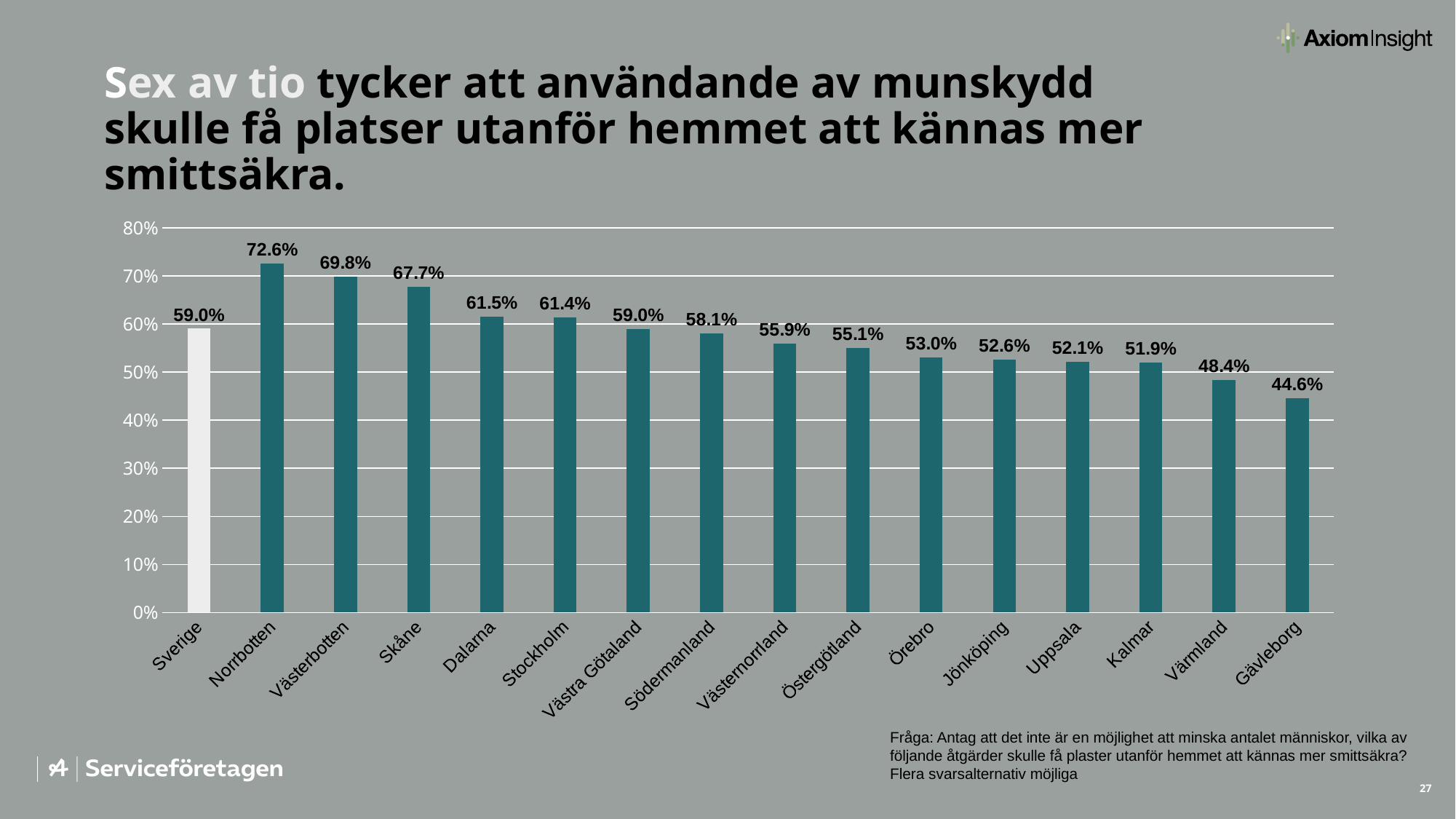
How many categories are shown on the x axis? 16 What kind of chart is shown on the slide? Bar chart What is the value for Sverige? 59.0% Which bar is shown in a different colour (light grey) from the others? Sverige Which category has the highest value? Norrbotten What is the difference between the values for Norrbotten and Gävleborg? 28.0% What is the value for Norrbotten? 72.6% What is the difference between the values for Skåne and Sverige? 8.7% Which has a larger value, Västerbotten or Dalarna? Västerbotten What is the value for Gävleborg? 44.6% What is the value for Stockholm? 61.4% Which category has the lowest value? Gävleborg